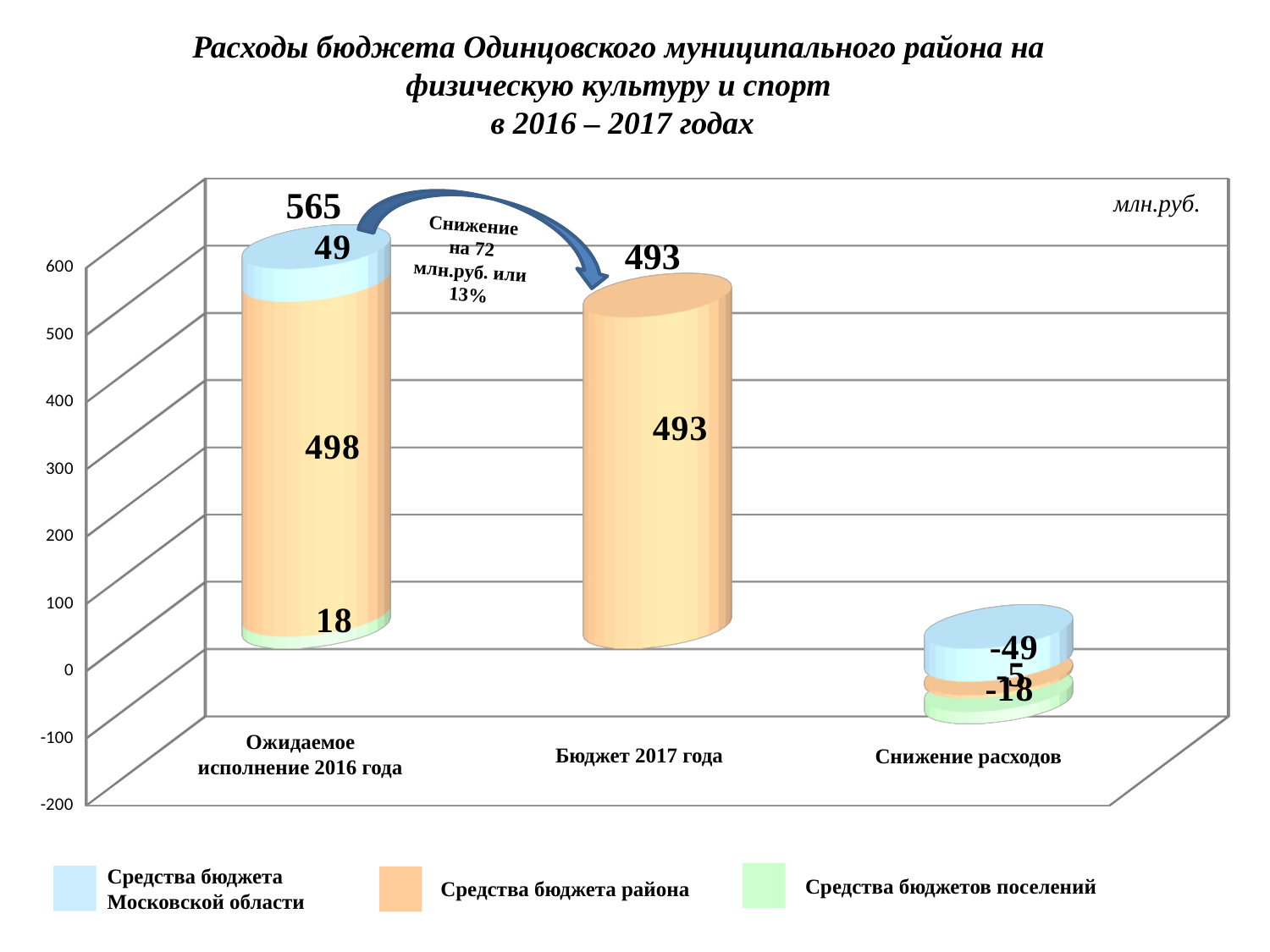
What kind of chart is shown on the slide? bar chart How many series does the legend list? 3 What is the total of the stacked bar for Ожидаемое исполнение 2016 года? 565 In what units are the values on the chart expressed? млн.руб. Which is larger, the total for Ожидаемое исполнение 2016 года or the total for Бюджет 2017 года? Ожидаемое исполнение 2016 года What is the value of Средства бюджета Московской области for Снижение расходов? -49 How many categories are shown on the x axis? 3 What is the value of Средства бюджета района for Ожидаемое исполнение 2016 года? 498 What is the value of Средства бюджета района for Бюджет 2017 года? 493 What is the value of Средства бюджетов поселений for Ожидаемое исполнение 2016 года? 18 What is the difference between Средства бюджета района in Ожидаемое исполнение 2016 года and in Бюджет 2017 года? 5 What is the value of Средства бюджета Московской области for Ожидаемое исполнение 2016 года? 49